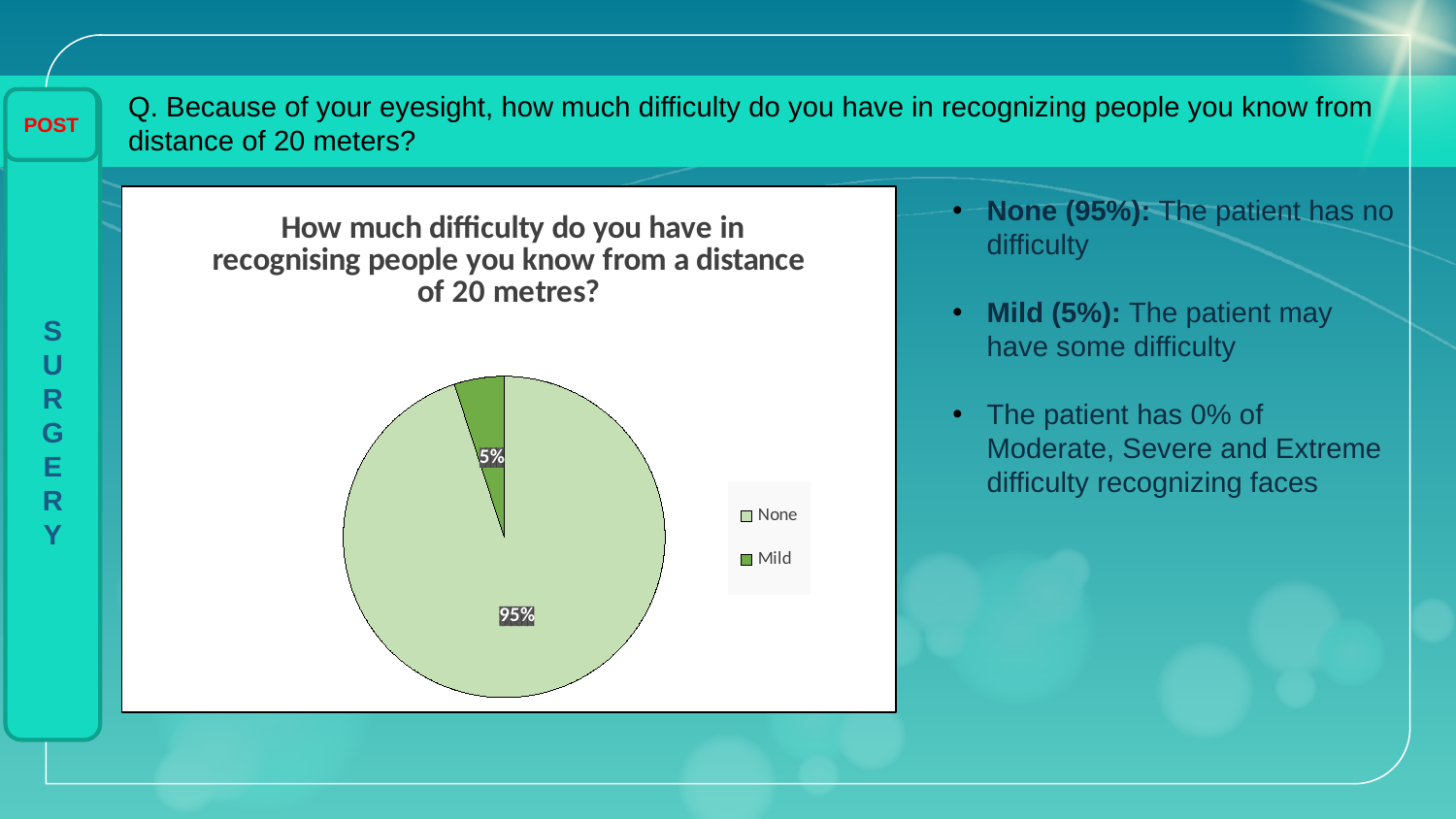
How many categories does the legend list? 2 Is the share for None greater or less than 50%? greater What kind of chart is shown on the slide? pie chart What is the combined share of the None and Mild slices? 100% What is the title of the chart? How much difficulty do you have in recognising people you know from a distance of 20 metres? Which category has the smallest share of the pie? Mild What percentage of the pie is labelled Mild? 5% What is the difference in percentage points between the None and Mild slices? 90 What colour is the Mild slice of the pie? dark green Which slice is larger, None or Mild? None What percentage of the pie is labelled None? 95% Which category has the largest share of the pie? None